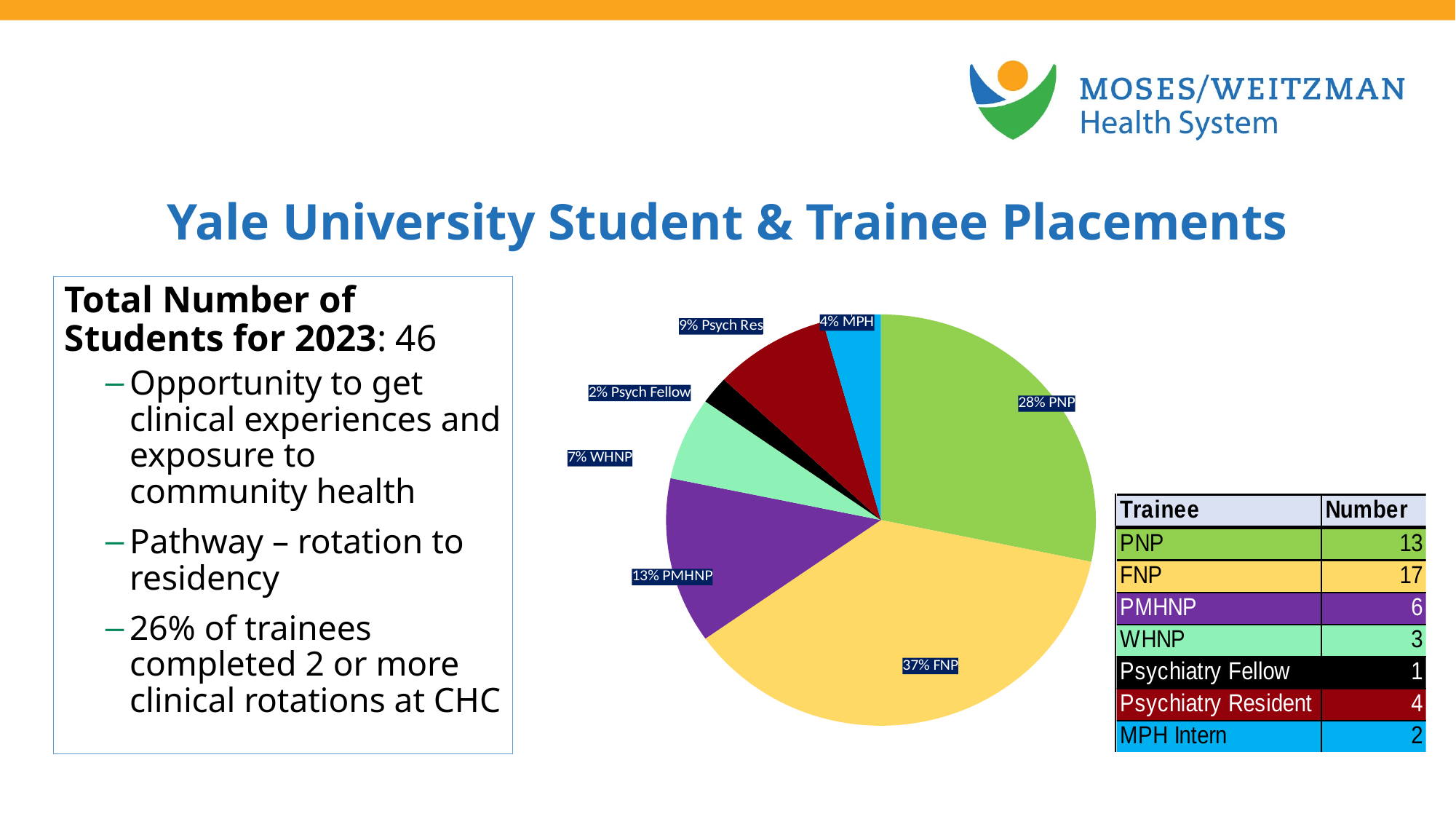
What share of the pie chart does PNP represent? 28% What kind of chart is shown on the slide? pie chart What percentage is shown for Psych Res in the pie chart? 9% Which category has the smallest slice of the pie chart? Psych Fellow According to the table next to the pie chart, how many FNP trainees are there? 17 What share of the pie chart does FNP represent? 37% Which category has the largest slice of the pie chart? FNP Which slice is larger in the pie chart, WHNP or MPH? WHNP What is the difference in percentage points between the FNP and PNP slices? 9 What colour is the PMHNP slice in the pie chart? purple What percentage is shown for PMHNP in the pie chart? 13% How many slices does the pie chart have? 7